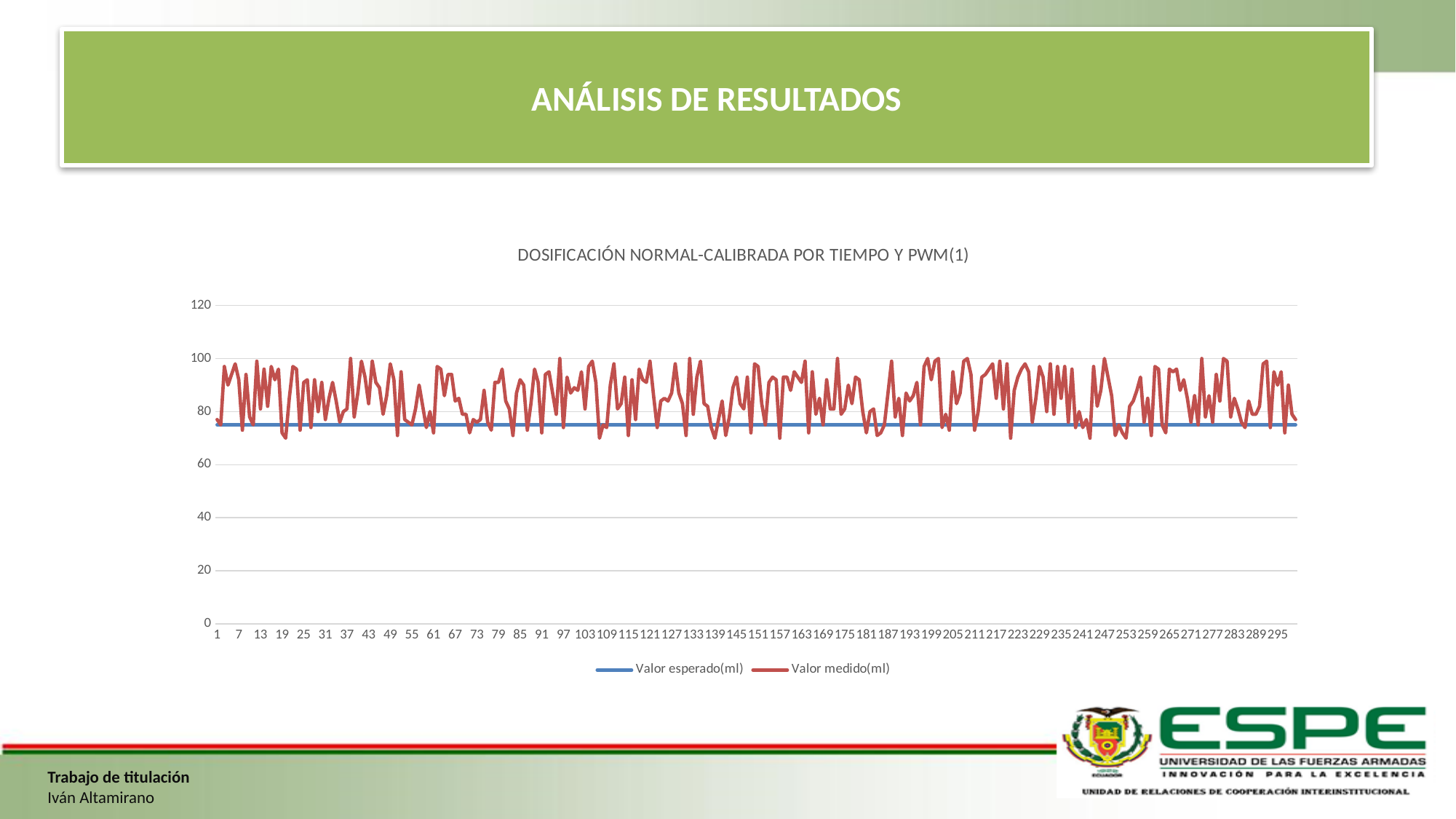
Is the value of the Valor esperado(ml) series greater or less than 60? greater Is the lowest value of the Valor medido(ml) series greater or less than 60? greater Which series generally has the higher values, Valor esperado(ml) or Valor medido(ml)? Valor medido(ml) How many series does the legend list? 2 Is the value of the Valor esperado(ml) series greater or less than 80? less Which series is drawn in red? Valor medido(ml) What kind of chart is shown on the slide? Line chart What is the title of the chart? DOSIFICACIÓN NORMAL-CALIBRADA POR TIEMPO Y PWM(1) Does the Valor esperado(ml) series rise, fall, or stay flat along the x axis? Stays flat